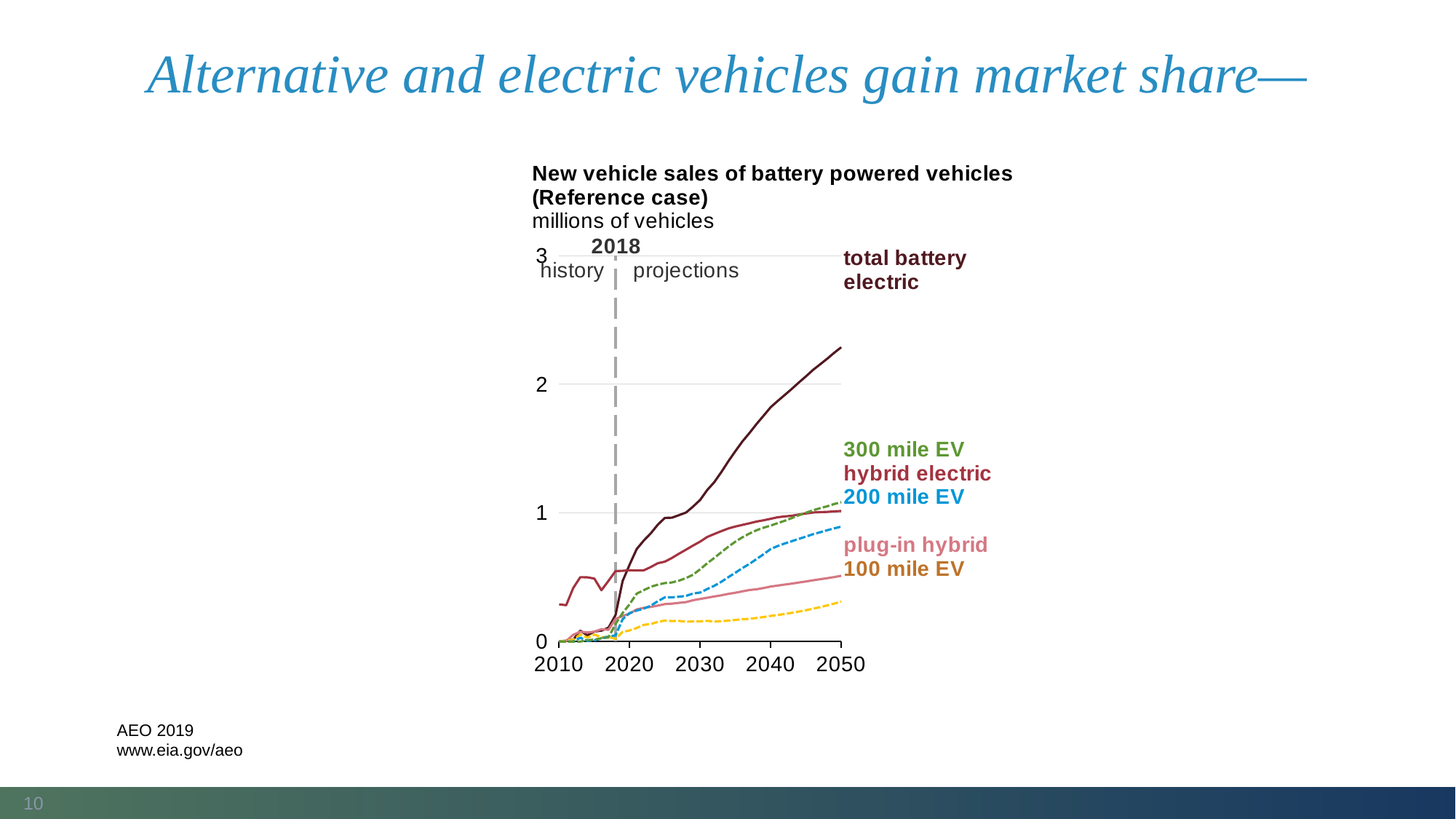
Which series has the highest value in 2050? total battery electric Which series has the lowest value in 2050? 100 mile EV Is the value for plug-in hybrid in 2050 greater or less than 1? less What unit is the y axis measured in? millions of vehicles Is the value for hybrid electric in 2050 greater or less than 2? less Is the value for total battery electric in 2050 greater or less than 2? greater What is the title of the chart? New vehicle sales of battery powered vehicles (Reference case) In 2050, which is larger: 300 mile EV or 100 mile EV? 300 mile EV What kind of chart is shown on the slide? line chart Does the total battery electric series rise or fall from 2018 to 2050? rise How many series are labelled on the chart? 6